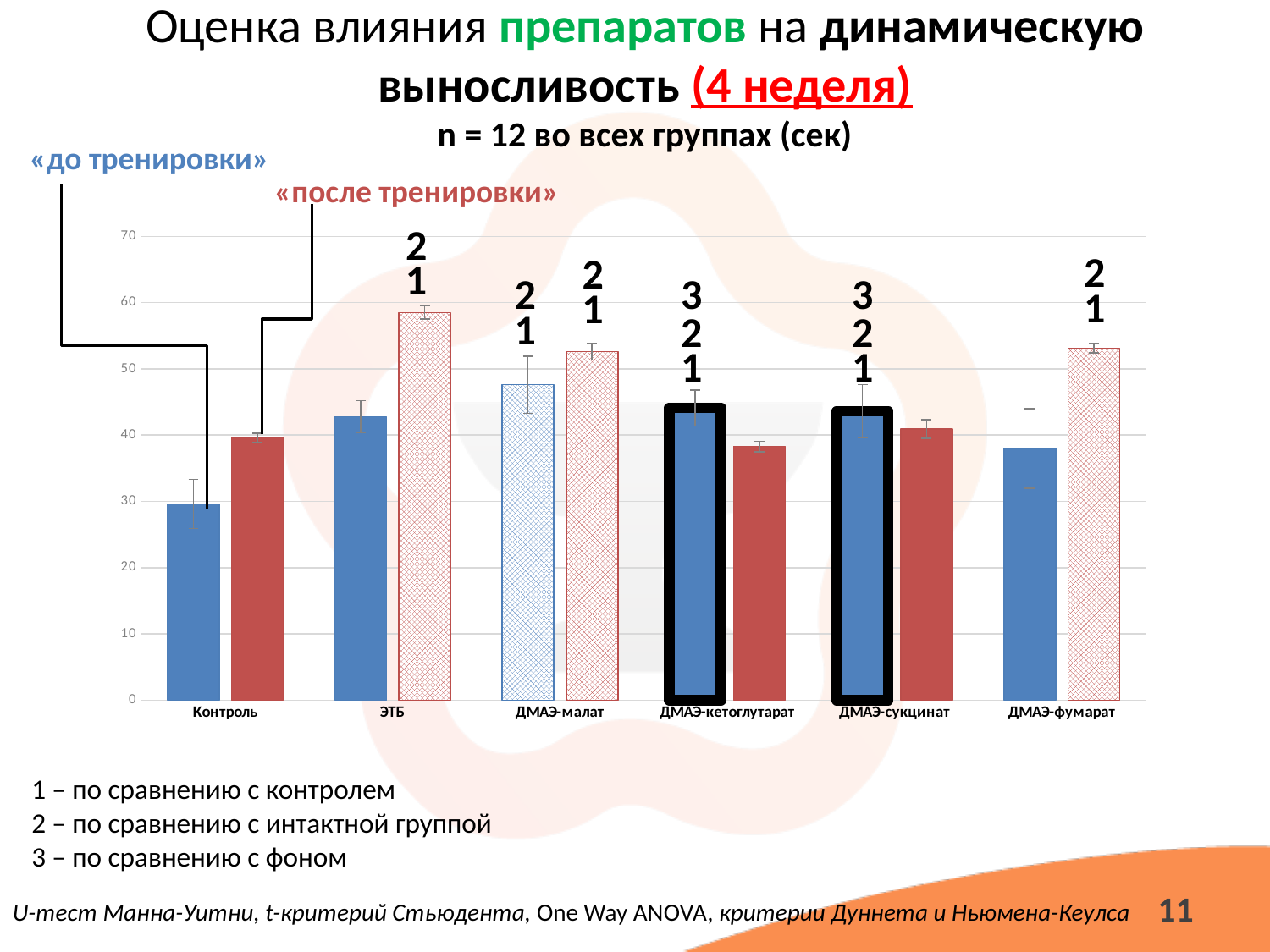
Which is larger for ДМАЭ-кетоглутарат: the «до тренировки» bar or the «после тренировки» bar? «до тренировки» How many groups (categories) are shown along the x axis of the chart? 6 How many data series does the chart show? 2 Is the «после тренировки» value for ЭТБ greater or less than 50? greater Which group has the larger «после тренировки» value: Контроль or ЭТБ? ЭТБ Is the «после тренировки» value for ДМАЭ-кетоглутарат greater or less than 40? less Is the «после тренировки» value for ДМАЭ-фумарат greater or less than 50? greater What kind of chart is shown on the slide? bar chart Which series is shown by the solid blue bars? «до тренировки» Which group has the lowest «до тренировки» bar? Контроль Which group has the highest «после тренировки» bar? ЭТБ